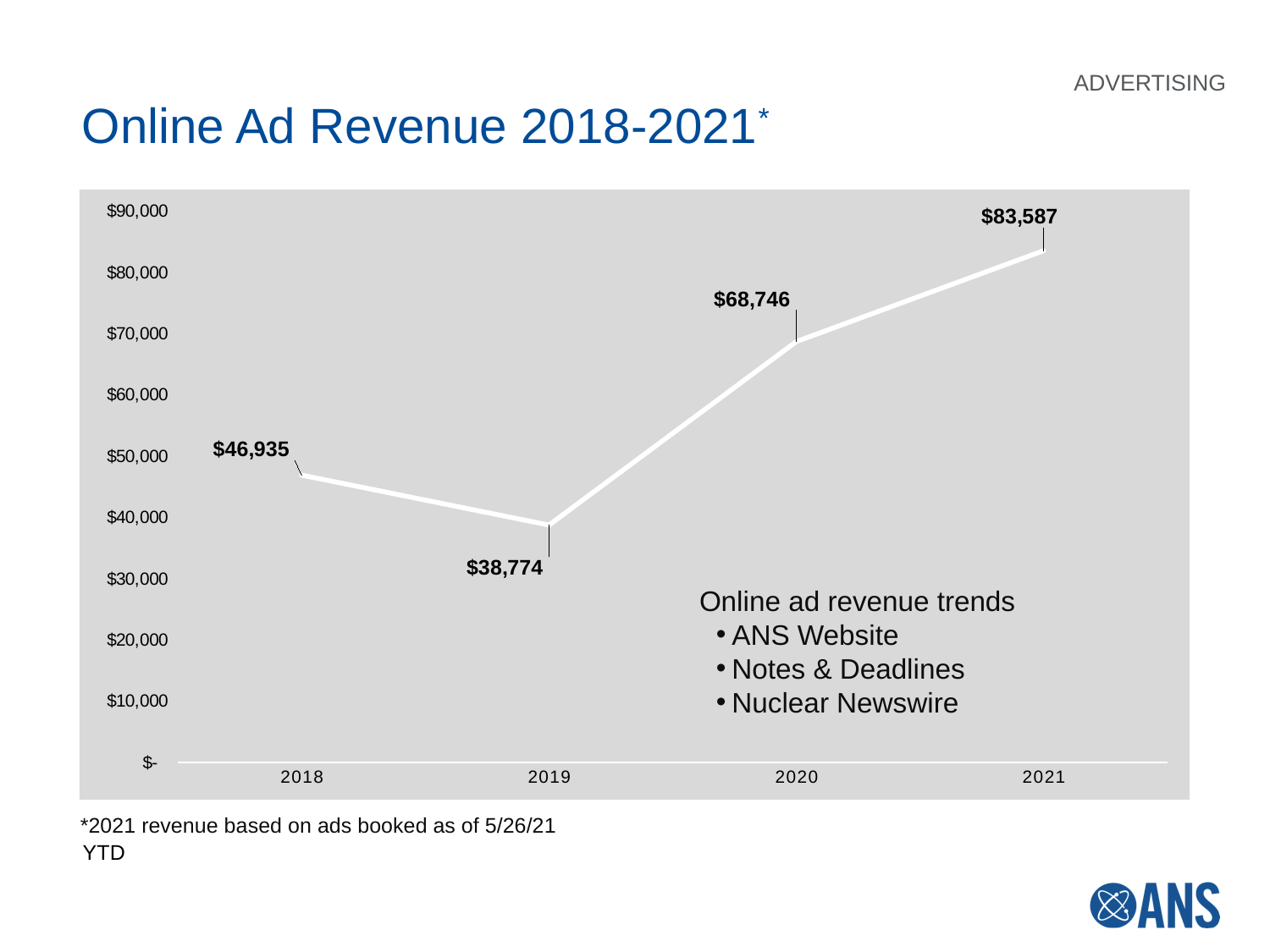
Which year had higher online ad revenue, 2018 or 2020? 2020 What is the difference in online ad revenue between 2021 and 2020? $14,841 What is the title of the chart on the slide? Online Ad Revenue 2018-2021 What was the online ad revenue in 2020? $68,746 What kind of chart is shown on the slide? Line chart What was the online ad revenue in 2018? $46,935 Which year had the highest online ad revenue? 2021 By how much did online ad revenue fall from 2018 to 2019? $8,161 What was the online ad revenue in 2019? $38,774 How many years are plotted on the chart? 4 Which year had the lowest online ad revenue? 2019 What was the online ad revenue in 2021? $83,587